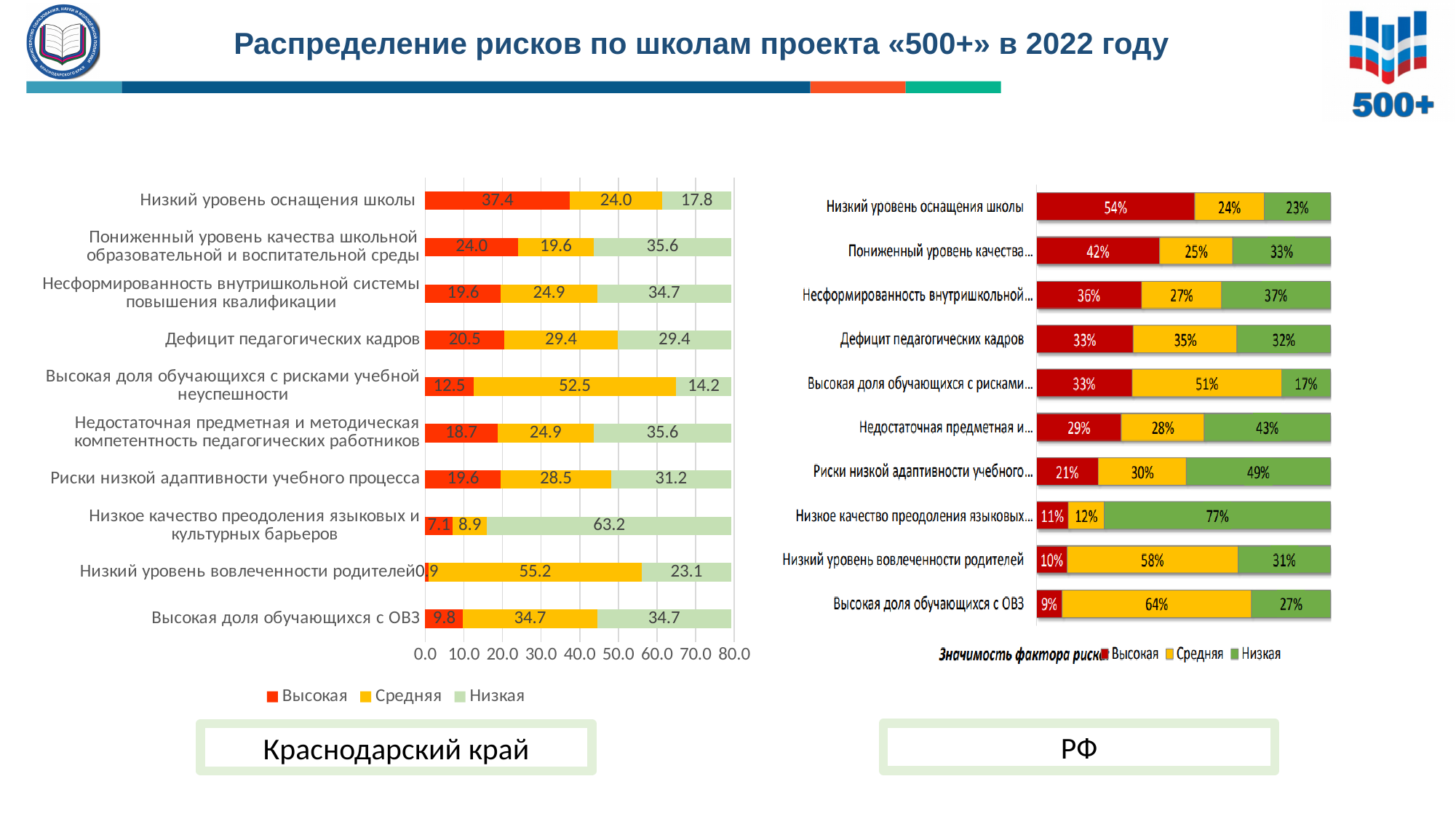
In the Краснодарский край chart, what is the total of the stacked bar for Дефицит педагогических кадров? 79.3 In the Краснодарский край chart, how many risk categories are plotted? 10 In the Краснодарский край chart, how many series does the legend list? 3 In the Краснодарский край chart, which category has the highest Средняя value? Низкий уровень вовлеченности родителей In the Краснодарский край chart, what is the Высокая value for Низкий уровень оснащения школы? 37.4 In the РФ chart, what is the Высокая value for Низкий уровень оснащения школы? 54% In the Краснодарский край chart, what is the Низкая value for Низкое качество преодоления языковых и культурных барьеров? 63.2 What kind of chart is the РФ chart? Stacked bar chart In the РФ chart, which category has the highest Низкая value? Низкое качество преодоления языковых... In the РФ chart, which category has the lowest Высокая value? Высокая доля обучающихся с ОВЗ In the РФ chart, which is larger for Дефицит педагогических кадров: the Высокая value or the Средняя value? Средняя In the Краснодарский край chart, what is the difference between the Средняя and Высокая values for Высокая доля обучающихся с рисками учебной неуспешности? 40.0